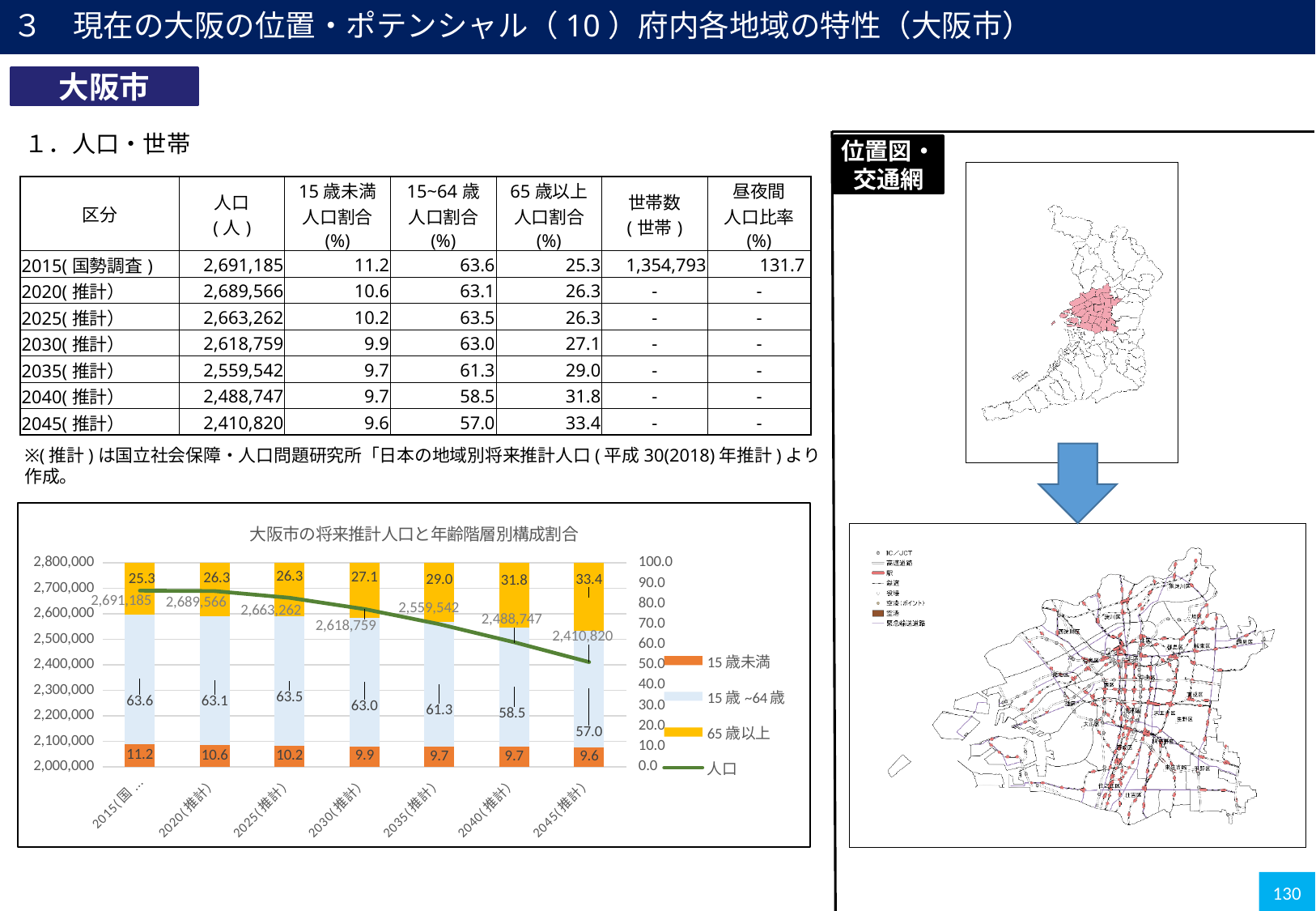
How many series does the legend list? 4 What is the difference between the 65歳以上 value for 2045(推計) and for 2015? 8.1 How many categories are shown on the x axis? 7 Which category has the lowest 人口 value? 2045(推計) What is the value of the 人口 line for 2045(推計)? 2,410,820 What kind of chart is this? Stacked bar chart combined with a line chart Which is larger, the 15歳~64歳 value for 2025(推計) or for 2030(推計)? 2025(推計) Which category has the highest 65歳以上 value? 2045(推計) What is the total of the stacked bar for 2040(推計)? 100.0 Does the 人口 line rise or fall from 2015 to 2045(推計)? Fall What is the 65歳以上 share shown for 2035(推計)? 29.0 What is the 15歳未満 share shown for 2020(推計)? 10.6